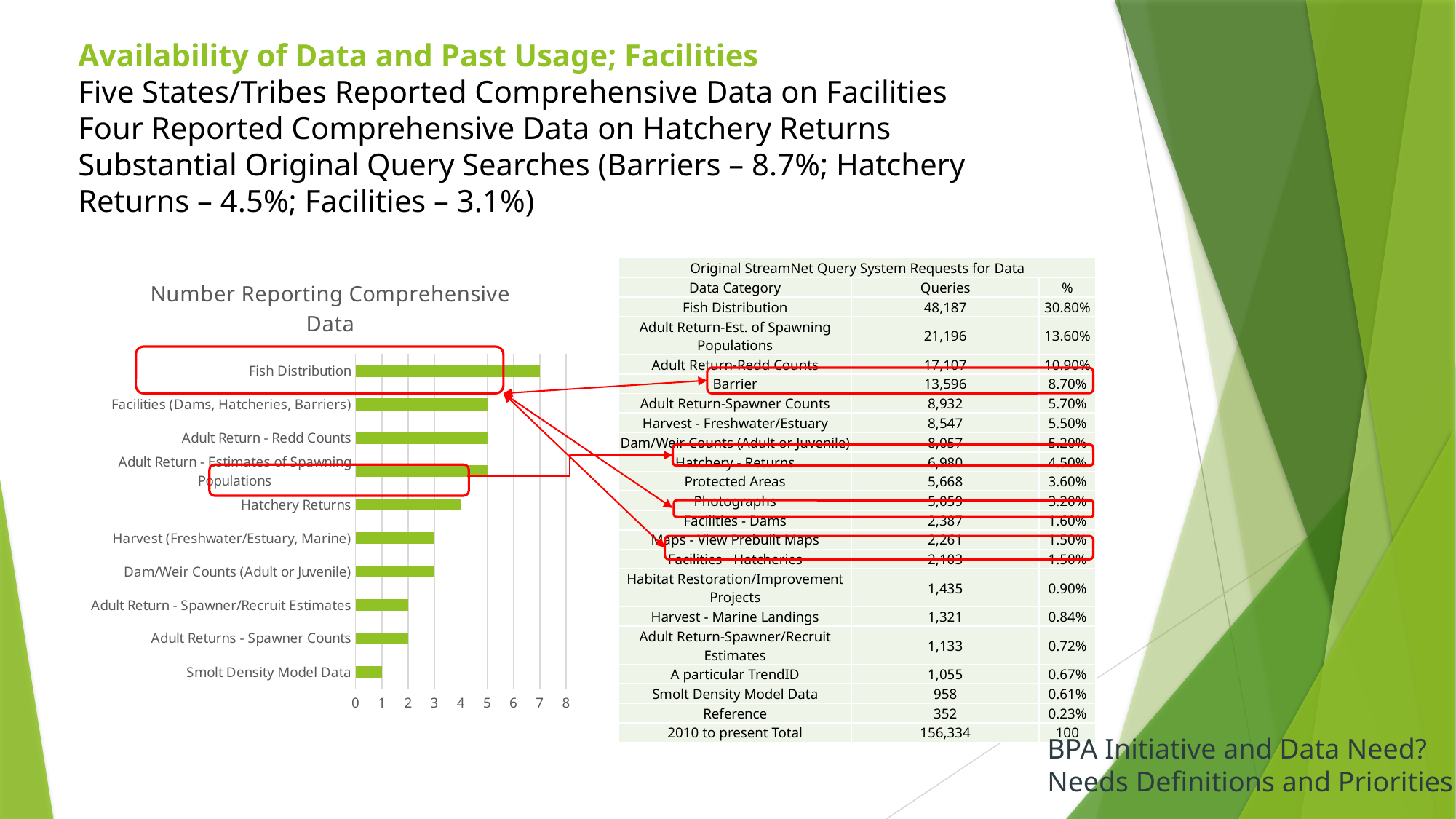
What is the title of the bar chart on the slide? Number Reporting Comprehensive Data In the 'Number Reporting Comprehensive Data' chart, what is the value for Hatchery Returns? 4 What kind of chart is 'Number Reporting Comprehensive Data'? bar chart In the 'Number Reporting Comprehensive Data' chart, is the value for Fish Distribution greater or less than 6? greater In the 'Number Reporting Comprehensive Data' chart, which is larger: Fish Distribution or Hatchery Returns? Fish Distribution In the 'Number Reporting Comprehensive Data' chart, is the value for Adult Returns - Spawner Counts greater or less than 3? less In the 'Number Reporting Comprehensive Data' chart, what is the difference between Facilities (Dams, Hatcheries, Barriers) and Hatchery Returns? 1 In the 'Number Reporting Comprehensive Data' chart, what is the value for Facilities (Dams, Hatcheries, Barriers)? 5 In the 'Number Reporting Comprehensive Data' chart, which category has the highest value? Fish Distribution In the 'Number Reporting Comprehensive Data' chart, which category has the lowest value? Smolt Density Model Data How many categories are shown in the 'Number Reporting Comprehensive Data' chart? 10 In the 'Number Reporting Comprehensive Data' chart, what is the value for Smolt Density Model Data? 1